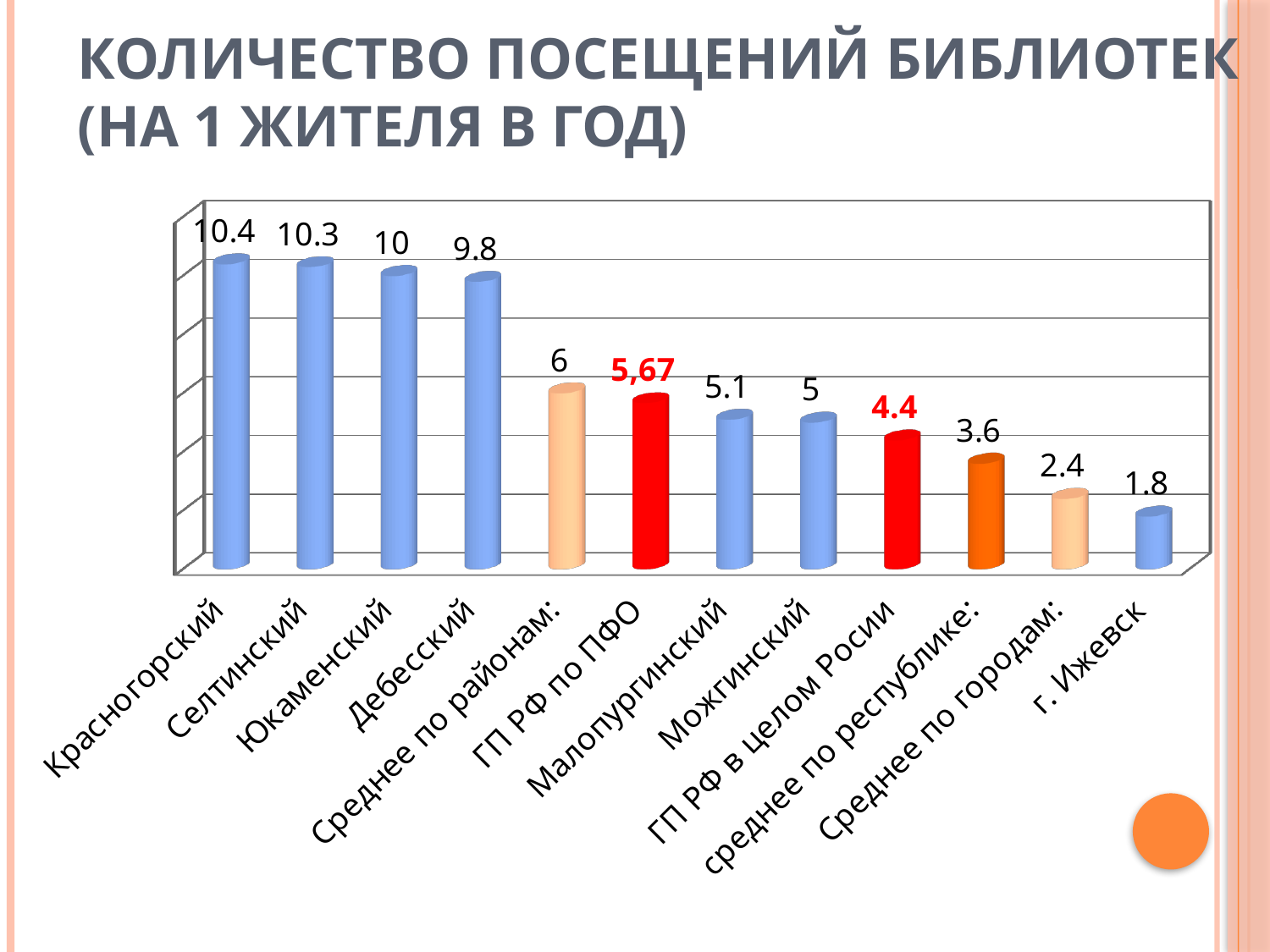
Which category has the lowest value? г. Ижевск What is the value for г. Ижевск? 1.8 What is the value for ГП РФ в целом Росии? 4.4 Which is larger, the value for Малопургинский or the value for Можгинский? Малопургинский How many categories are shown in the chart? 12 What is the value for Красногорский? 10.4 What is the value for Среднее по районам:? 6 What kind of chart is shown on the slide? Bar chart What is the value for ГП РФ по ПФО? 5,67 What is the difference between the values for Красногорский and Дебесский? 0.6 Do the values rise or fall from left to right along the x axis? Fall Which category has the highest value? Красногорский